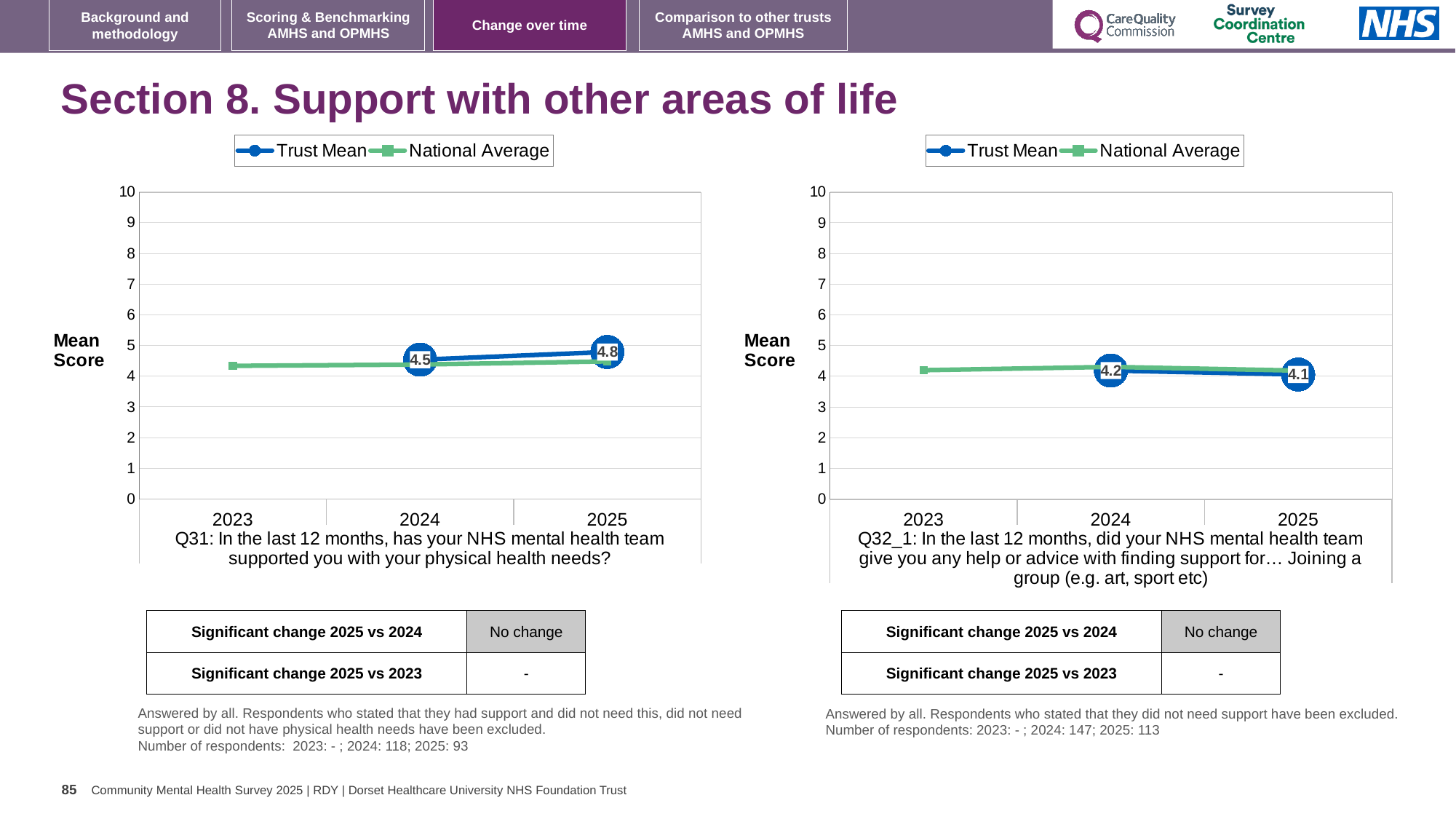
In the left chart (Q31), is the National Average for 2023 greater or less than 5? less What type of chart is used on the left (Q31)? line chart In the left chart (Q31), by how much did the Trust Mean change from 2024 to 2025? 0.3 In the right chart (Q32_1), what is the Trust Mean for 2024? 4.2 In the right chart (Q32_1), what is the difference between the Trust Mean in 2024 and in 2025? 0.1 In the right chart (Q32_1), what is the Trust Mean for 2025? 4.1 In the left chart (Q31), is the Trust Mean higher in 2024 or 2025? 2025 In the left chart (Q31), what is the Trust Mean for 2025? 4.8 In the left chart (Q31), what is the Trust Mean for 2024? 4.5 How many years are shown on the x axis of the left chart (Q31)? 3 In the right chart (Q32_1), does the Trust Mean rise or fall from 2024 to 2025? fall How many series does the legend of the right chart (Q32_1) list? 2